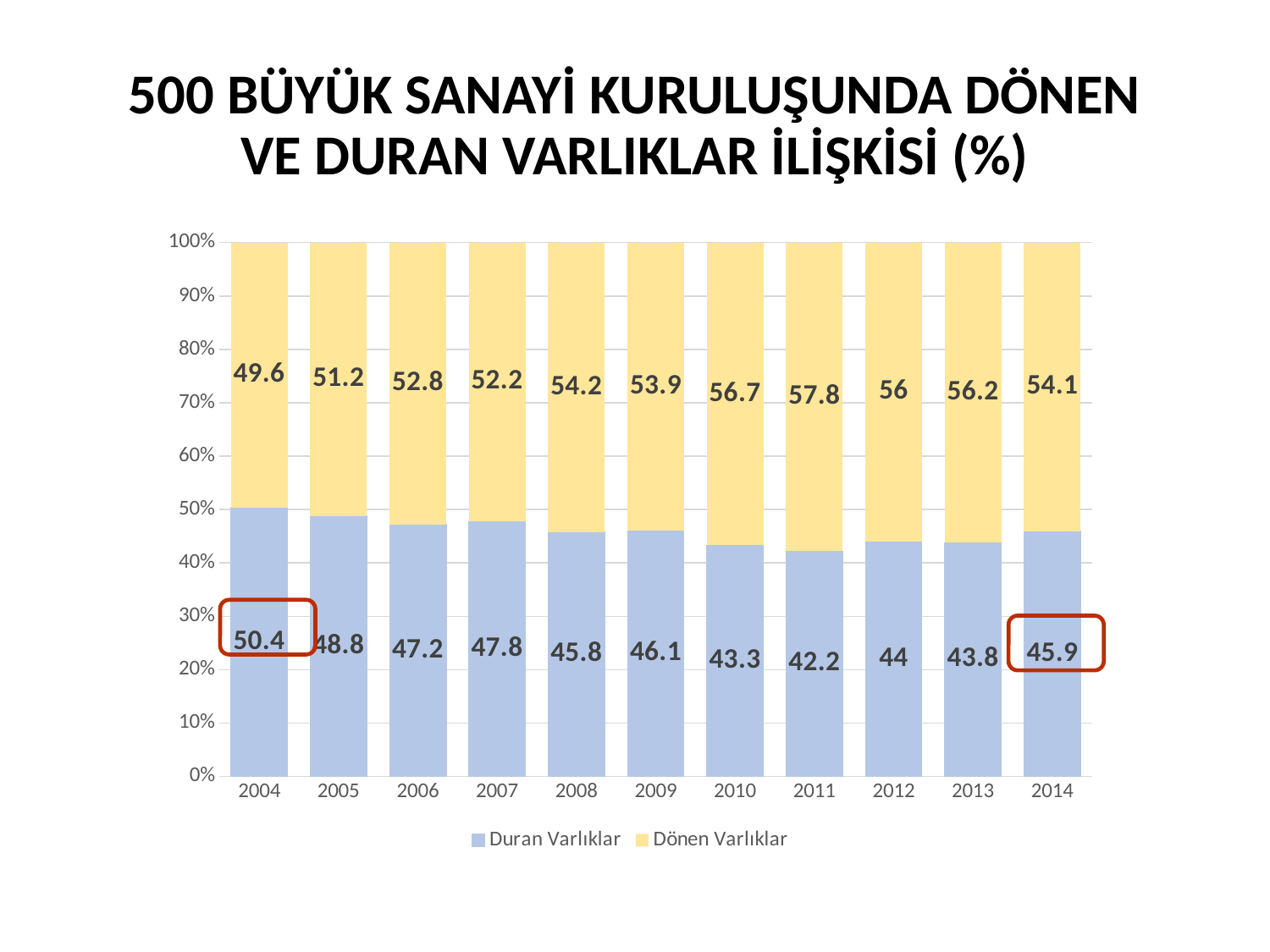
In which year is the Dönen Varlıklar value highest? 2011 Which colour represents Dönen Varlıklar in the chart? Yellow How many series does the legend list? 2 What is the value for Dönen Varlıklar in 2011? 57.8 What is the value for Duran Varlıklar in 2014? 45.9 What kind of chart is shown on the slide? Stacked bar chart Does the Duran Varlıklar value rise or fall from 2004 to 2011? Fall How many years are shown on the x axis? 11 Which is larger in 2012: Duran Varlıklar or Dönen Varlıklar? Dönen Varlıklar What is the value for Duran Varlıklar in 2004? 50.4 In which year is the Duran Varlıklar value lowest? 2011 What is the difference between the Duran Varlıklar values for 2004 and 2014? 4.5